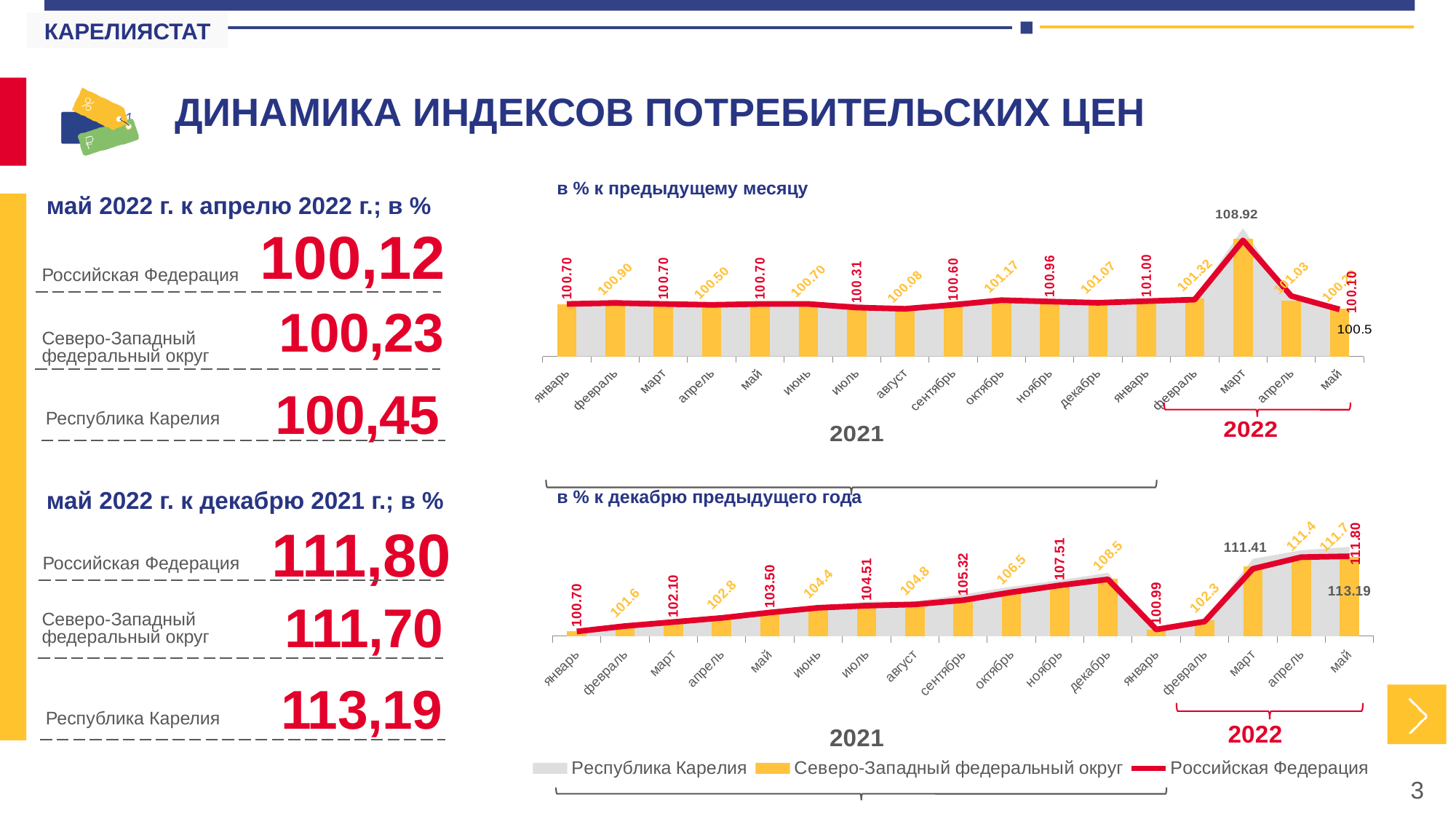
In the bottom chart (в % к декабрю предыдущего года), what is the difference between the Республика Карелия value (113.19) and the Российская Федерация value (111.80) in май 2022? 1.39 In the top chart (в % к предыдущему месяцу), what is the peak value labelled for март 2022? 108.92 In the top chart (в % к предыдущему месяцу), how many months are shown on the x axis? 17 In the bottom chart (в % к декабрю предыдущего года), which is larger: the value labelled for март 2022 (111.41) or for май 2022 (113.19)? май 2022 Which series is shown as a red line in the charts? Российская Федерация Which series is shown as yellow bars in the charts? Северо-Западный федеральный округ How many series does the legend list for the charts on the slide? 3 In the bottom chart (в % к декабрю предыдущего года), what is the value for Российская Федерация in май 2022? 111.80 In the top chart (в % к предыдущему месяцу), which month has the highest value? март 2022 In the bottom chart (в % к декабрю предыдущего года), which month has the lowest value? январь 2021 In the bottom chart (в % к декабрю предыдущего года), what is the value for Республика Карелия in май 2022? 113.19 In the bottom chart (в % к декабрю предыдущего года), do the values rise or fall from январь to декабрь 2021? rise